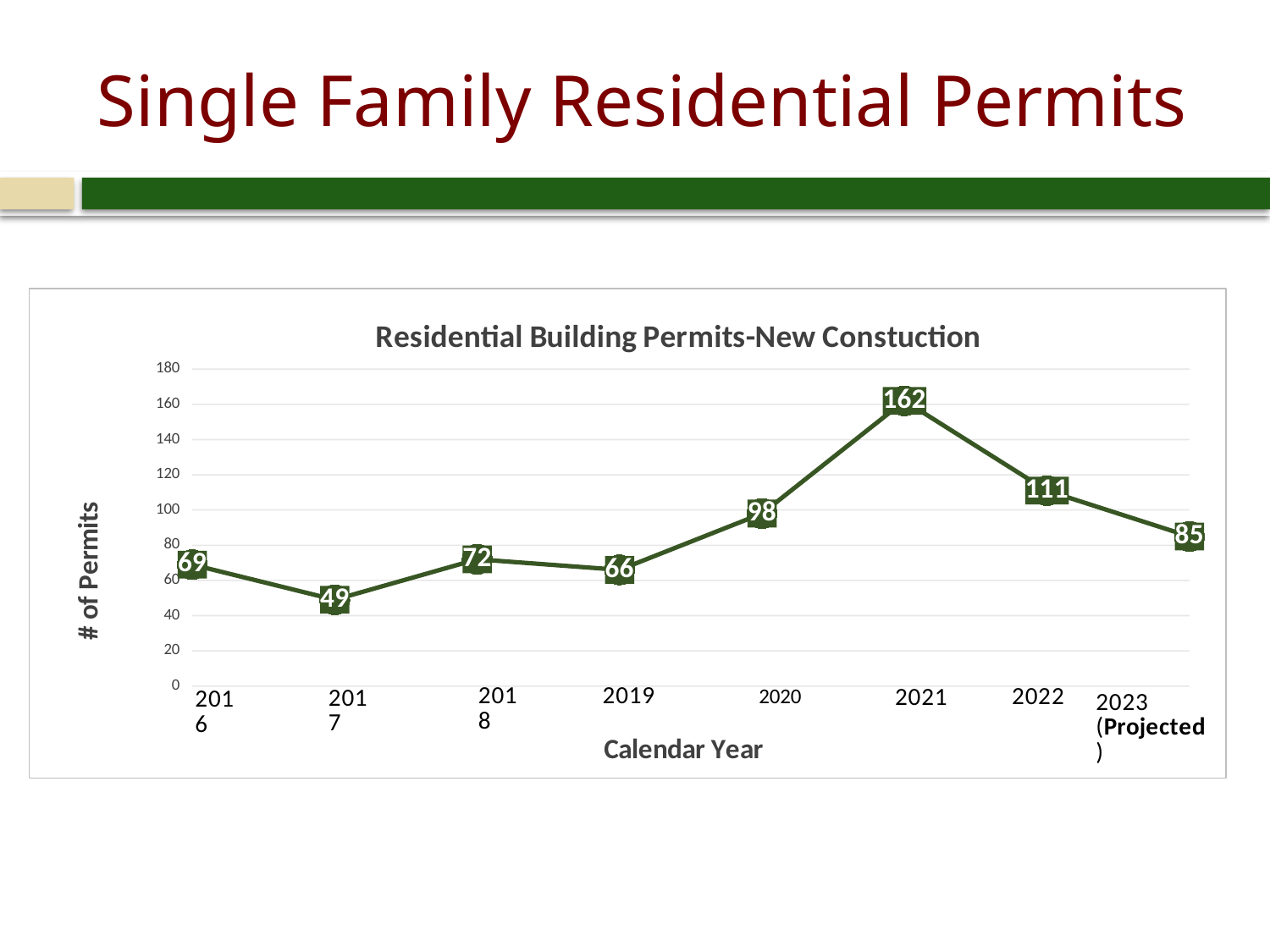
What kind of chart is shown on the slide? line chart Did the number of permits rise or fall from 2019 to 2021? rise How many years are plotted on the chart? 8 What is the value for 2017? 49 What is the title of the chart? Residential Building Permits-New Constuction What is the label of the vertical axis? # of Permits What is the projected number of permits for 2023? 85 Which year has the lowest number of permits? 2017 What is the difference between the number of permits in 2021 and 2022? 51 How many permits were issued in 2021? 162 Which year has the highest number of permits? 2021 Which year had more permits, 2018 or 2019? 2018